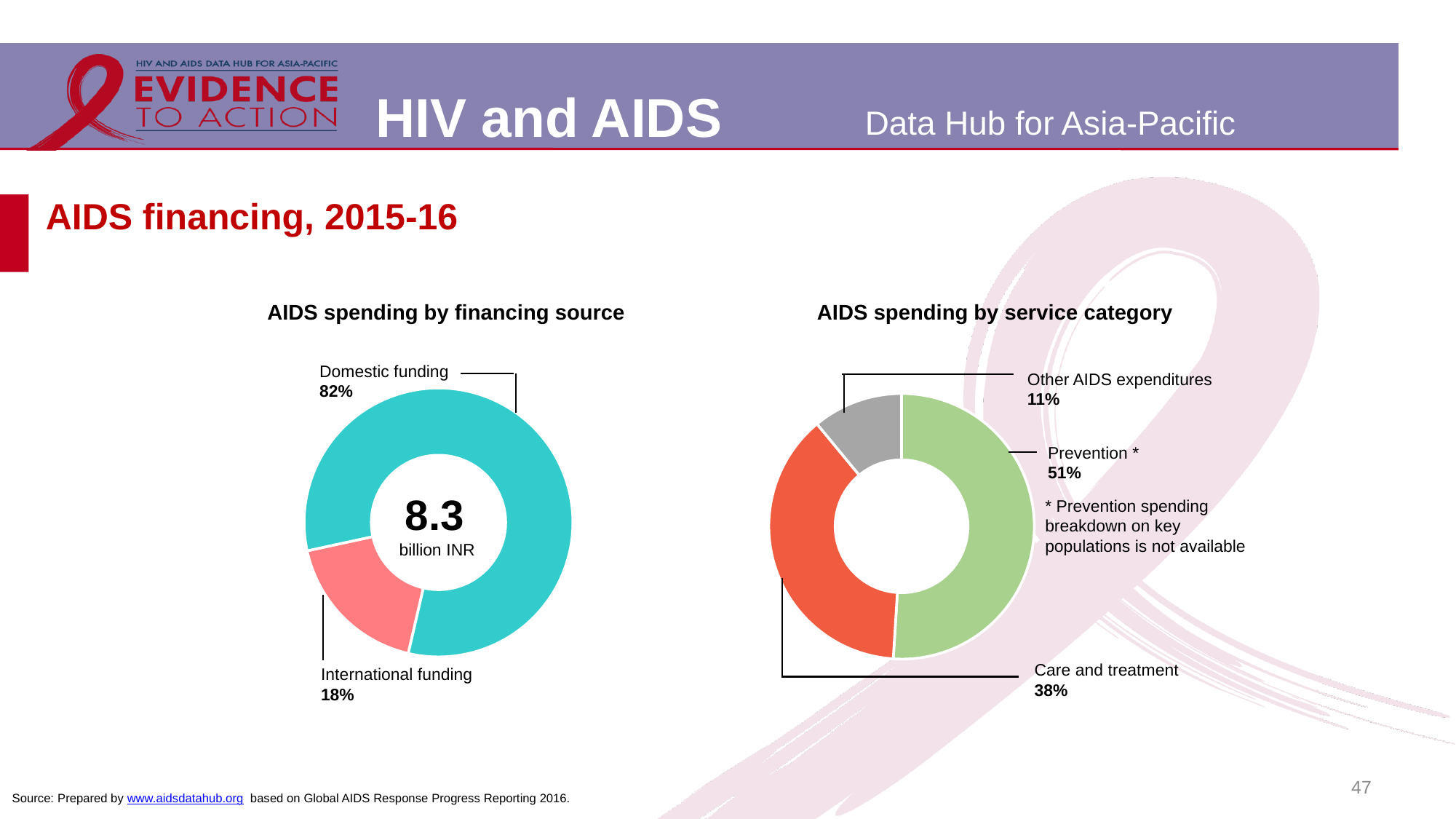
In the 'AIDS spending by financing source' chart, how many percentage points larger is domestic funding than international funding? 64 percentage points In the 'AIDS spending by financing source' chart, what total amount is shown in the centre of the donut? 8.3 billion INR In the 'AIDS spending by service category' chart, what share of spending goes to prevention? 51% In the 'AIDS spending by service category' chart, how many percentage points larger is prevention than care and treatment? 13 percentage points In the 'AIDS spending by service category' chart, how many service categories are shown? 3 In the 'AIDS spending by financing source' chart, what share of spending comes from international funding? 18% In the 'AIDS spending by financing source' chart, what share of spending comes from domestic funding? 82% In the 'AIDS spending by service category' chart, what share of spending goes to care and treatment? 38% In the 'AIDS spending by service category' chart, which service category has the smallest share? Other AIDS expenditures In the 'AIDS spending by financing source' chart, which financing source has the larger share? Domestic funding In the 'AIDS spending by service category' chart, what share of spending goes to other AIDS expenditures? 11% What kind of chart is used for 'AIDS spending by financing source'? Donut (pie) chart